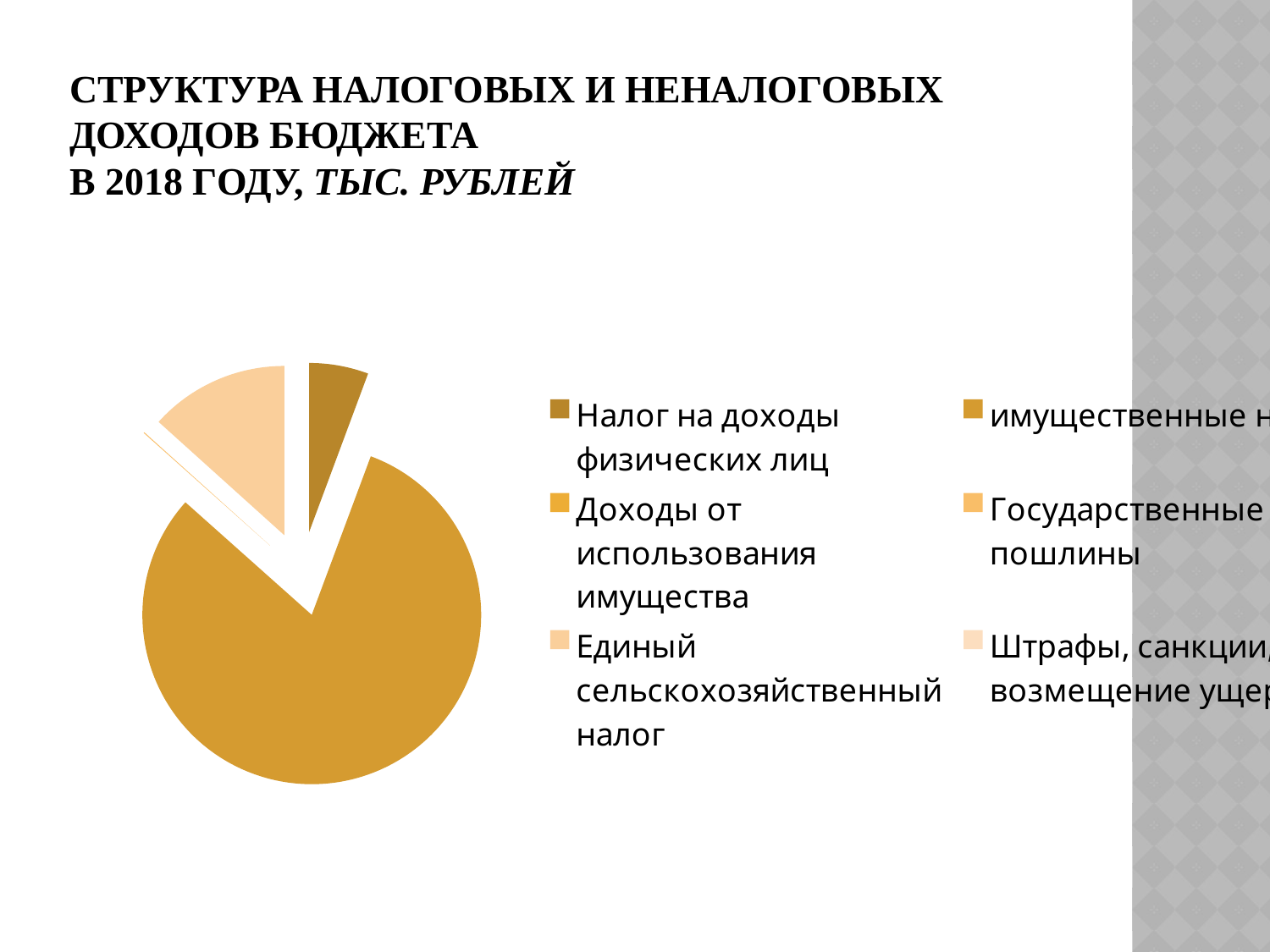
Which slice is larger: Налог на доходы физических лиц or Единый сельскохозяйственный налог? Единый сельскохозяйственный налог What year does the chart title say the budget revenue structure refers to? 2018 Does the slice for Единый сельскохозяйственный налог make up more or less than half of the pie? less Does the slice for Налог на доходы физических лиц make up more or less than half of the pie? less How many entries does the legend of the pie chart list? 6 In what units does the chart title say the values are given? тыс. рублей What kind of chart is shown on the slide? pie chart